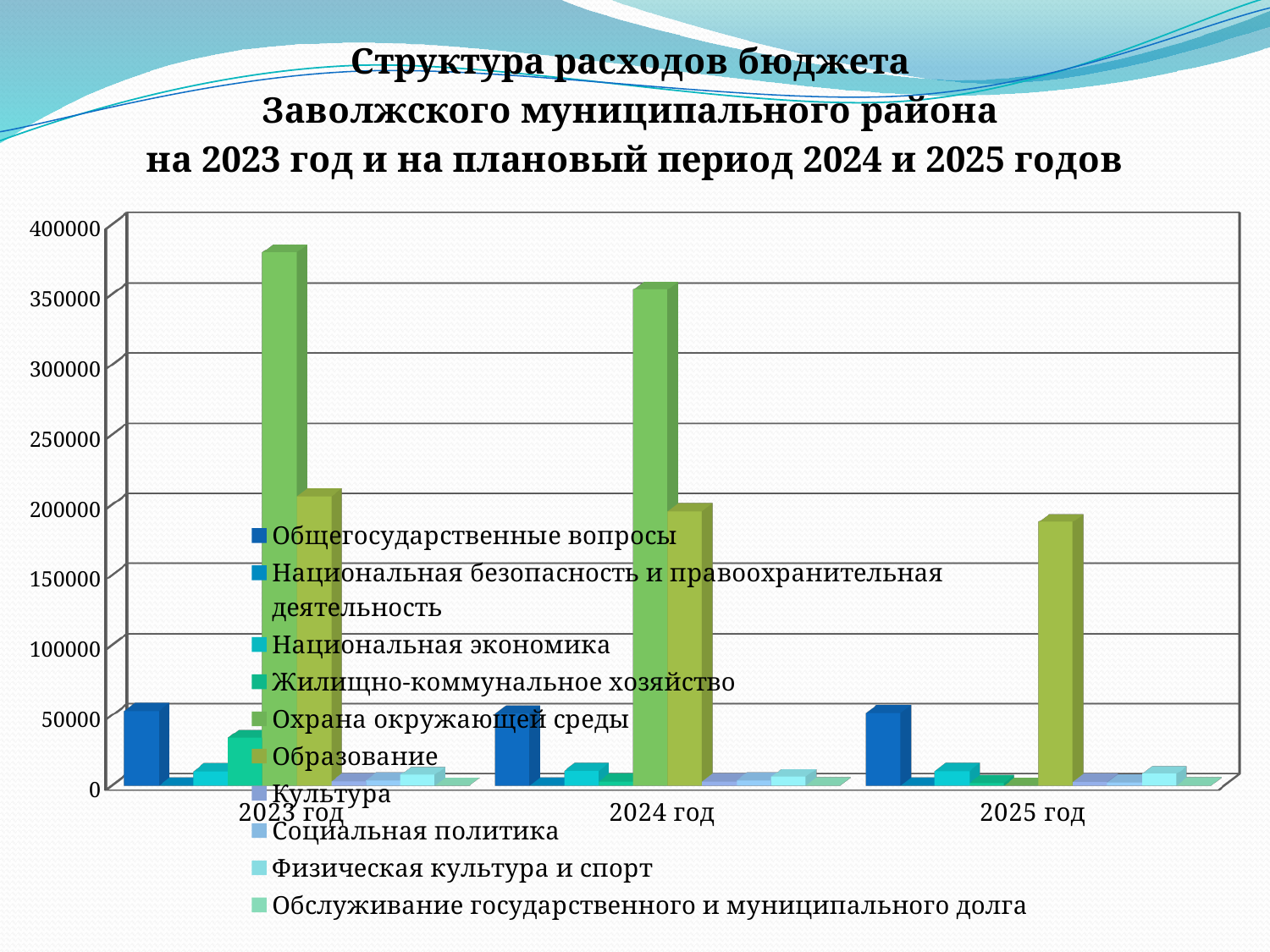
Is the tallest bar for 2024 год greater or less than 300000? greater Does the tallest bar in each year rise or fall from 2023 год to 2025 год? fall What is the last series listed in the legend? Обслуживание государственного и муниципального долга How many series does the legend list? 10 Which year has the tallest bar in the chart? 2023 год Which is larger: the tallest bar for 2023 год or the tallest bar for 2025 год? 2023 год How many year categories are shown on the x axis? 3 Is the value for Общегосударственные вопросы in 2023 год greater or less than 100000? less What kind of chart is shown on the slide? bar chart What is the first series listed in the legend? Общегосударственные вопросы Is the tallest bar for 2023 год greater or less than 350000? greater